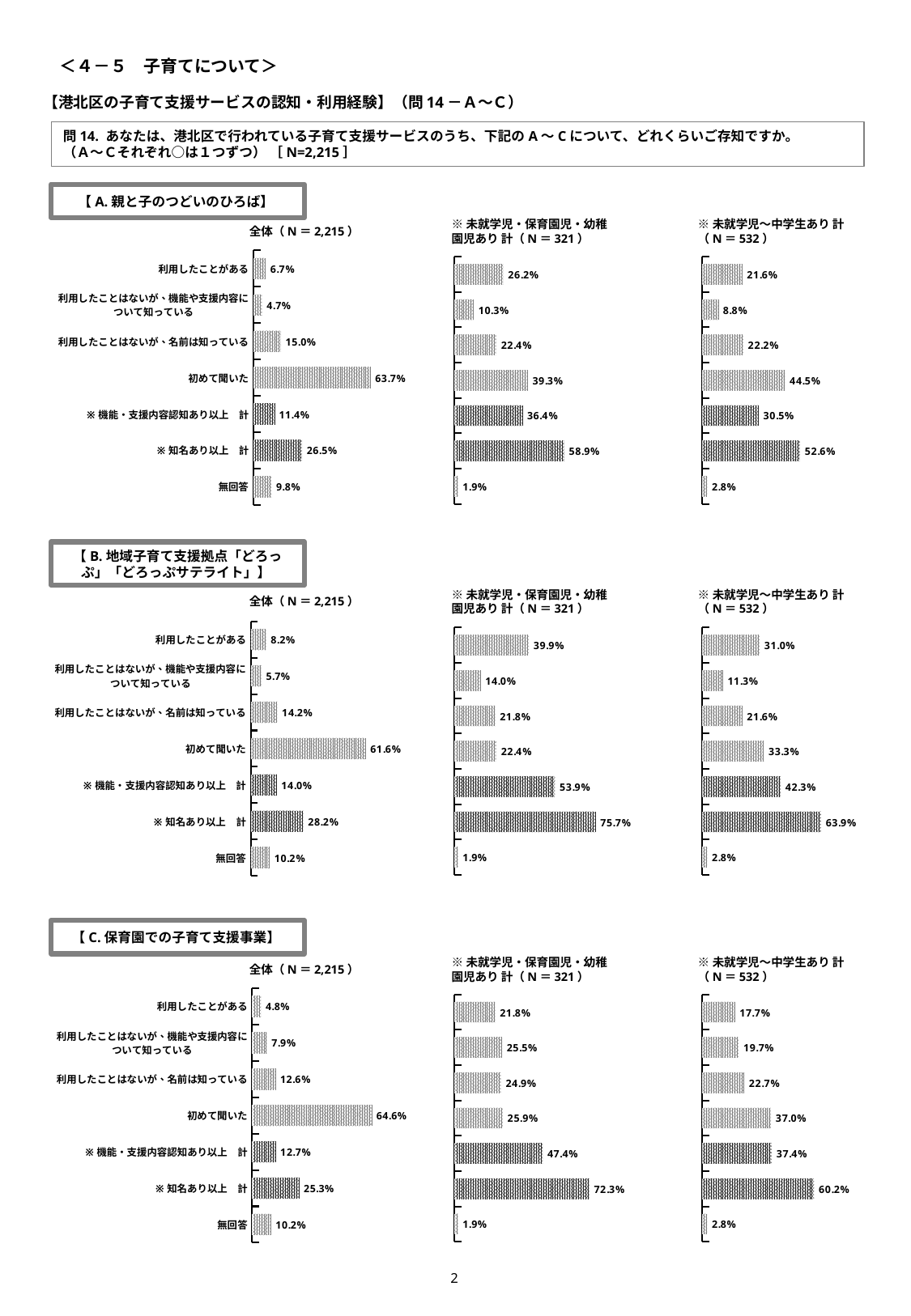
In section B (地域子育て支援拠点「どろっぷ」「どろっぷサテライト」), which is larger for 利用したことがある: the 未就学児・保育園児・幼稚園児あり計 (N=321) chart or the 未就学児～中学生あり計 (N=532) chart? 未就学児・保育園児・幼稚園児あり計 (N=321) In section A (親と子のつどいのひろば), 全体 (N=2,215) chart, what is the difference between 初めて聞いた and 利用したことがある? 57.0% In section B (地域子育て支援拠点「どろっぷ」「どろっぷサテライト」), 未就学児・保育園児・幼稚園児あり計 (N=321) chart, which category has the lowest value? 無回答 In section C (保育園での子育て支援事業), 全体 (N=2,215) chart, which category has the highest value? 初めて聞いた In section A (親と子のつどいのひろば), 未就学児・保育園児・幼稚園児あり計 (N=321) chart, what is the value for 利用したことがある? 26.2% In section B (地域子育て支援拠点「どろっぷ」「どろっぷサテライト」), 未就学児～中学生あり計 (N=532) chart, what is the value for ※知名あり以上 計? 63.9% How many categories are shown in section A (親と子のつどいのひろば), 全体 (N=2,215) chart? 7 In section A (親と子のつどいのひろば), 全体 (N=2,215) chart, what is the value for 初めて聞いた? 63.7% What type of chart is used in section A (親と子のつどいのひろば), 全体 (N=2,215)? Bar chart In section C (保育園での子育て支援事業), 未就学児～中学生あり計 (N=532) chart, what is the value for 初めて聞いた? 37.0% In section C (保育園での子育て支援事業), 未就学児・保育園児・幼稚園児あり計 (N=321) chart, what is the difference between ※知名あり以上 計 and ※機能・支援内容認知あり以上 計? 24.9% In section C (保育園での子育て支援事業), 全体 (N=2,215) chart, what is the value for 無回答? 10.2%